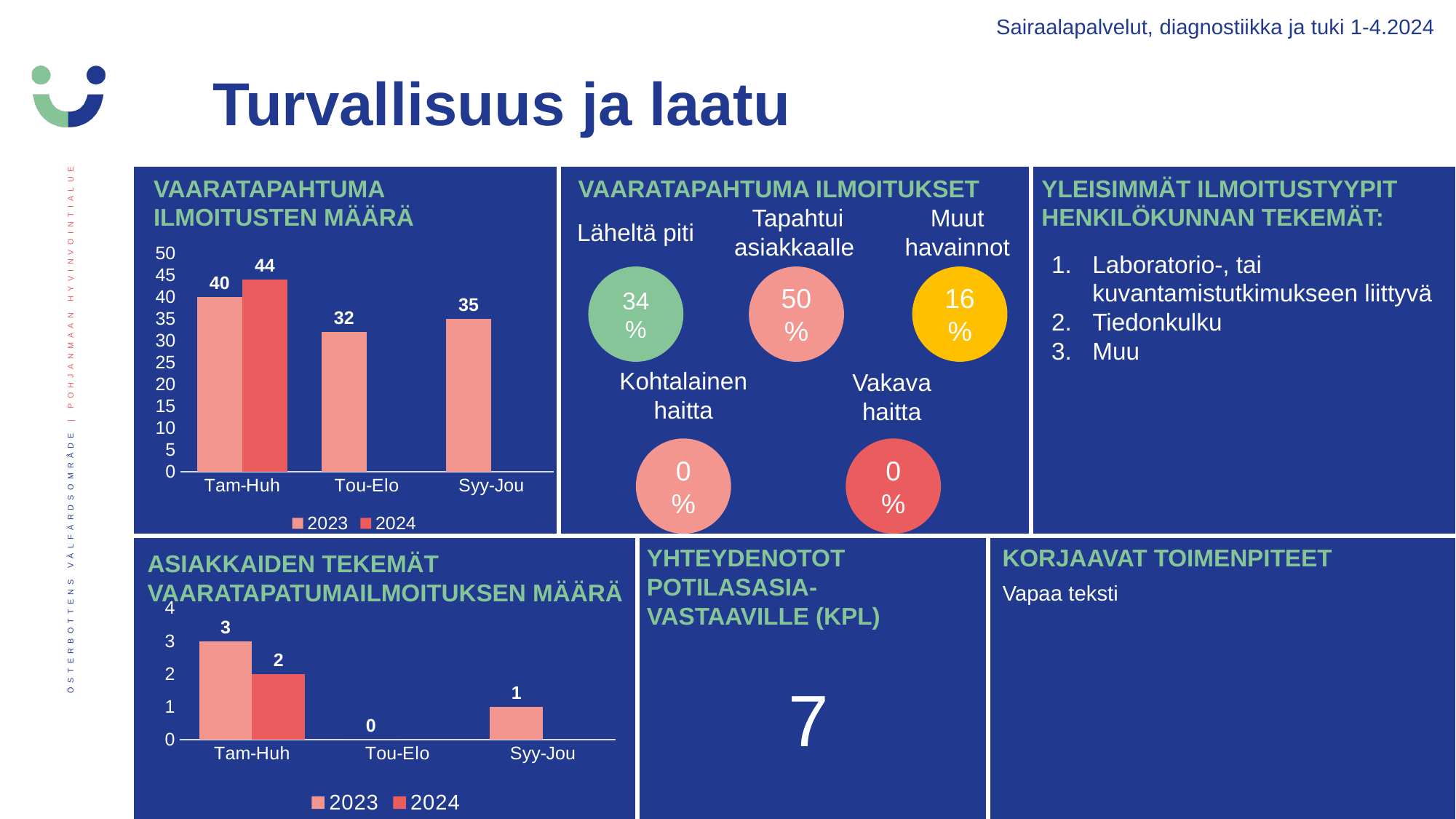
In the chart titled VAARATAPAHTUMA ILMOITUSTEN MÄÄRÄ, what is the difference between the 2024 and 2023 values for Tam-Huh? 4 In the chart titled VAARATAPAHTUMA ILMOITUSTEN MÄÄRÄ, which category has the lowest 2023 value? Tou-Elo In the chart titled ASIAKKAIDEN TEKEMÄT VAARATAPATUMAILMOITUKSEN MÄÄRÄ, how many categories are shown on the x axis? 3 In the chart titled ASIAKKAIDEN TEKEMÄT VAARATAPATUMAILMOITUKSEN MÄÄRÄ, which category has the highest 2023 value? Tam-Huh In the chart titled VAARATAPAHTUMA ILMOITUSTEN MÄÄRÄ, which is larger: the 2023 value for Syy-Jou or the 2023 value for Tou-Elo? Syy-Jou In the chart titled ASIAKKAIDEN TEKEMÄT VAARATAPATUMAILMOITUKSEN MÄÄRÄ, what is the 2024 value for Tam-Huh? 2 In the chart titled VAARATAPAHTUMA ILMOITUSTEN MÄÄRÄ, what is the 2024 value for Tam-Huh? 44 What kind of chart is the one titled VAARATAPAHTUMA ILMOITUSTEN MÄÄRÄ? Bar chart In the chart titled VAARATAPAHTUMA ILMOITUSTEN MÄÄRÄ, what is the 2023 value for Tam-Huh? 40 In the chart titled ASIAKKAIDEN TEKEMÄT VAARATAPATUMAILMOITUKSEN MÄÄRÄ, what is the 2023 value for Tam-Huh? 3 In the chart titled VAARATAPAHTUMA ILMOITUSTEN MÄÄRÄ, how many series does the legend list? 2 In the chart titled VAARATAPAHTUMA ILMOITUSTEN MÄÄRÄ, what is the 2023 value for Tou-Elo? 32